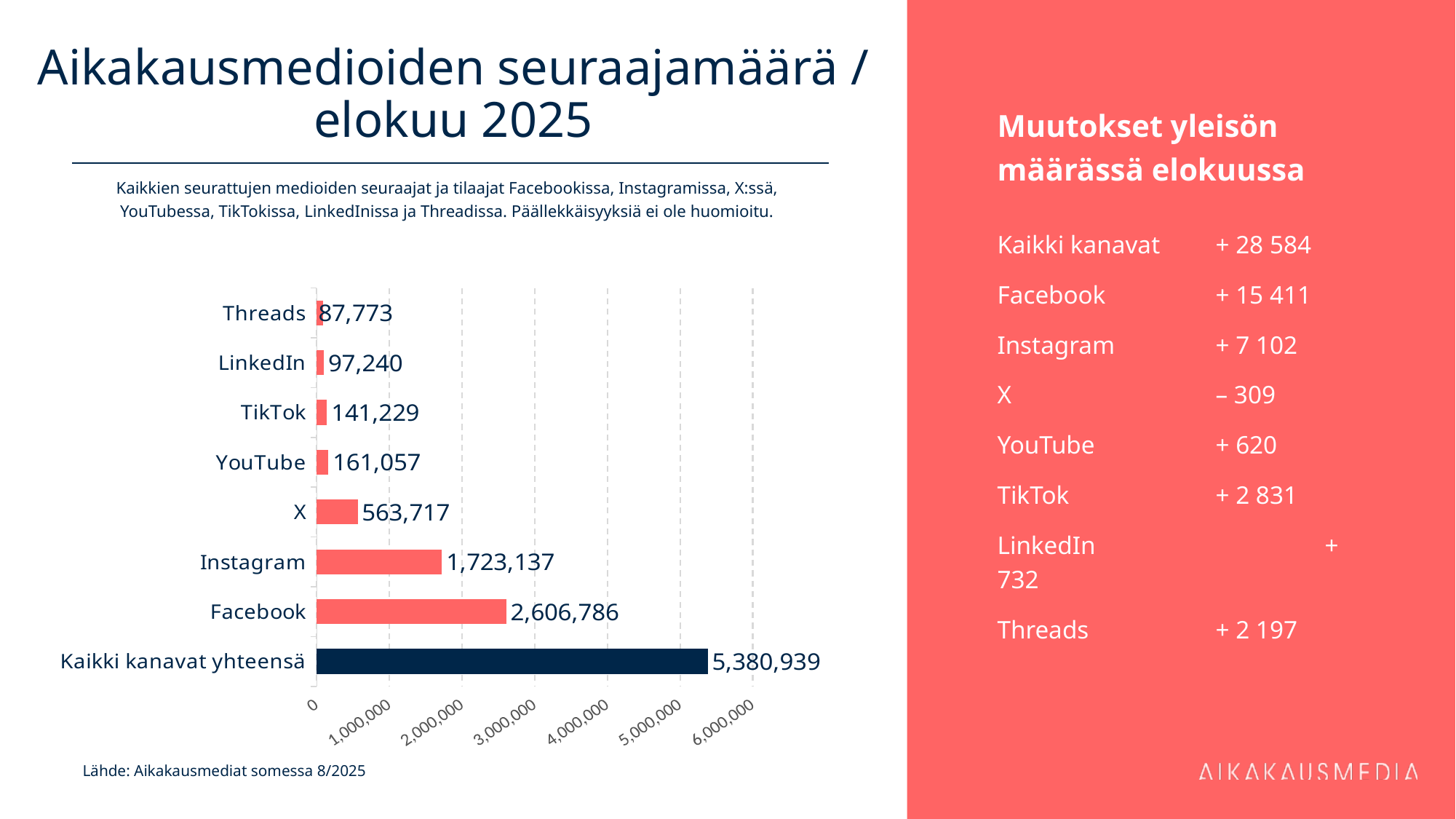
Which is larger, the value for X or the value for YouTube? X What is the difference between the values for Facebook and Instagram? 883,649 Excluding the total bar, which channel has the highest value? Facebook What is the difference between the values for YouTube and TikTok? 19,828 What is the value for Kaikki kanavat yhteensä? 5,380,939 Which channel has the lowest value? Threads What is the value for X? 563,717 What is the value for Threads? 87,773 What is the value for Instagram? 1,723,137 How many bars are shown in the chart? 8 What kind of chart is shown on the slide? Bar chart What is the value for Facebook? 2,606,786